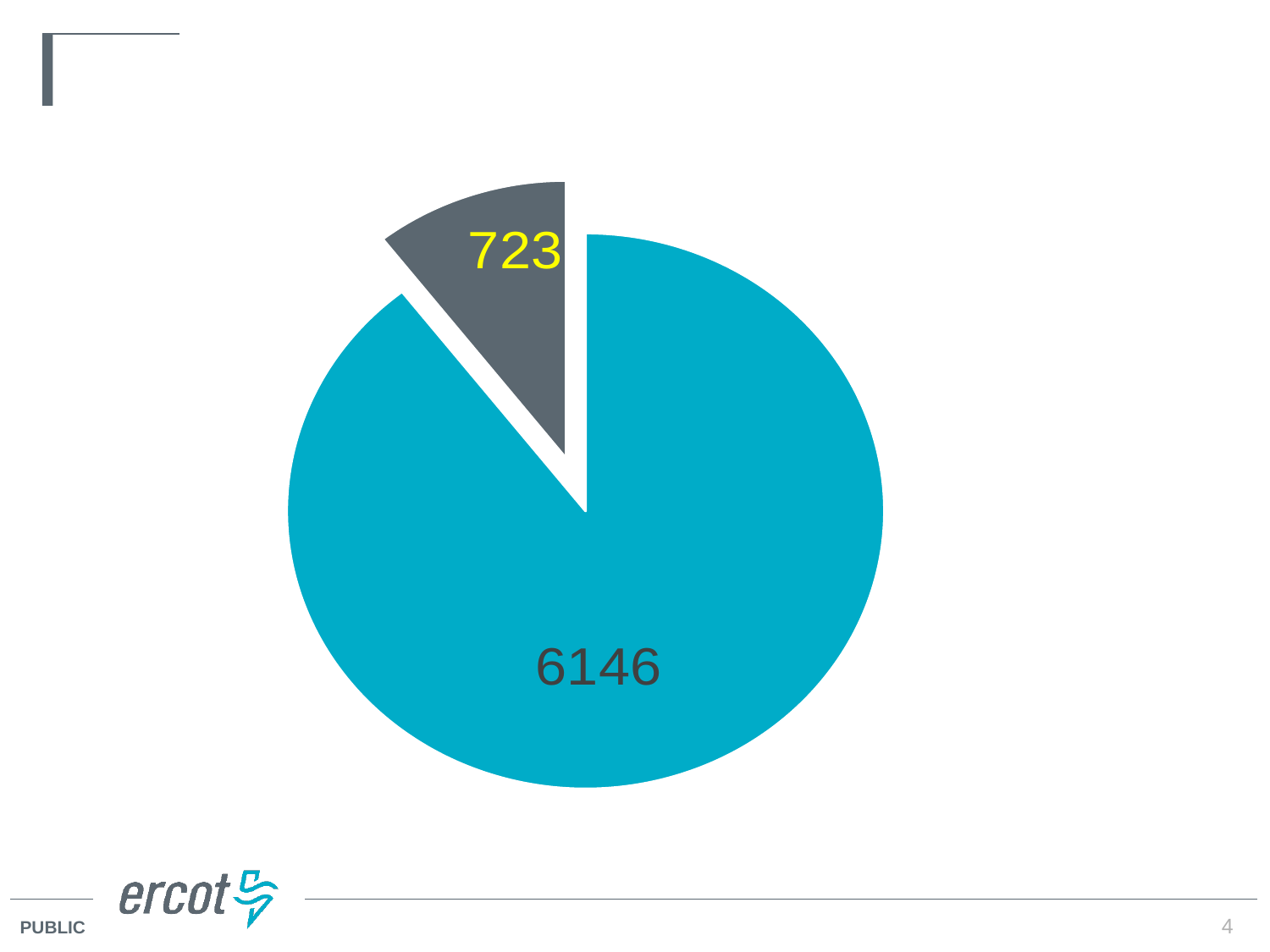
How many slices does the pie chart have? 2 What is the difference between the two slice values, 6146 and 723? 5423 What kind of chart is shown on the slide? Pie chart What colour is the data label on the small slice of the pie chart? Yellow What value is labelled on the large teal slice of the pie chart? 6146 Which slice of the pie chart is the smallest? The dark grey slice (723) What share of the pie does the slice labelled 723 represent, to one decimal place? 10.5% What is the total of the two slice values in the pie chart? 6869 Is the slice labelled 6146 larger or smaller than the slice labelled 723? Larger Which slice of the pie chart is pulled out (exploded) from the rest of the pie? The dark grey slice labelled 723 Which slice of the pie chart is the largest? The teal slice (6146) What value is labelled on the small dark grey slice of the pie chart? 723